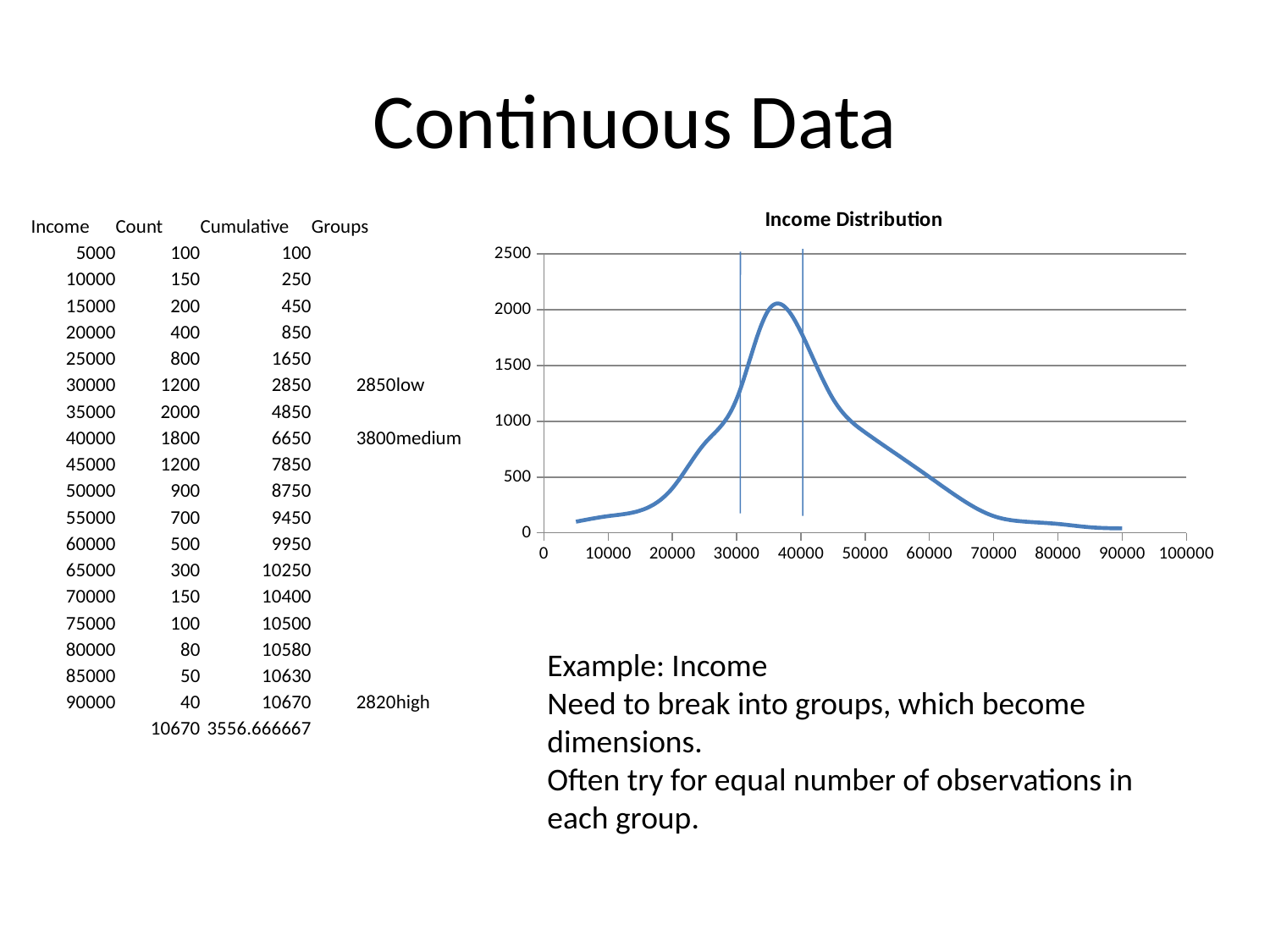
At which income value does the Income Distribution line reach its highest point? 35000 Do the values rise or fall along the x axis from 40000 to 90000? fall Which has the larger value, income 40000 or income 45000? 40000 Is the value for income 50000 greater or less than 1000? less Is the value for income 20000 greater or less than 500? less What kind of chart is shown on the slide? line chart What is the highest value shown on the chart's vertical axis? 2500 Is the value for income 70000 greater or less than 500? less What is the title of the chart? Income Distribution Which has the larger value, income 30000 or income 50000? 30000